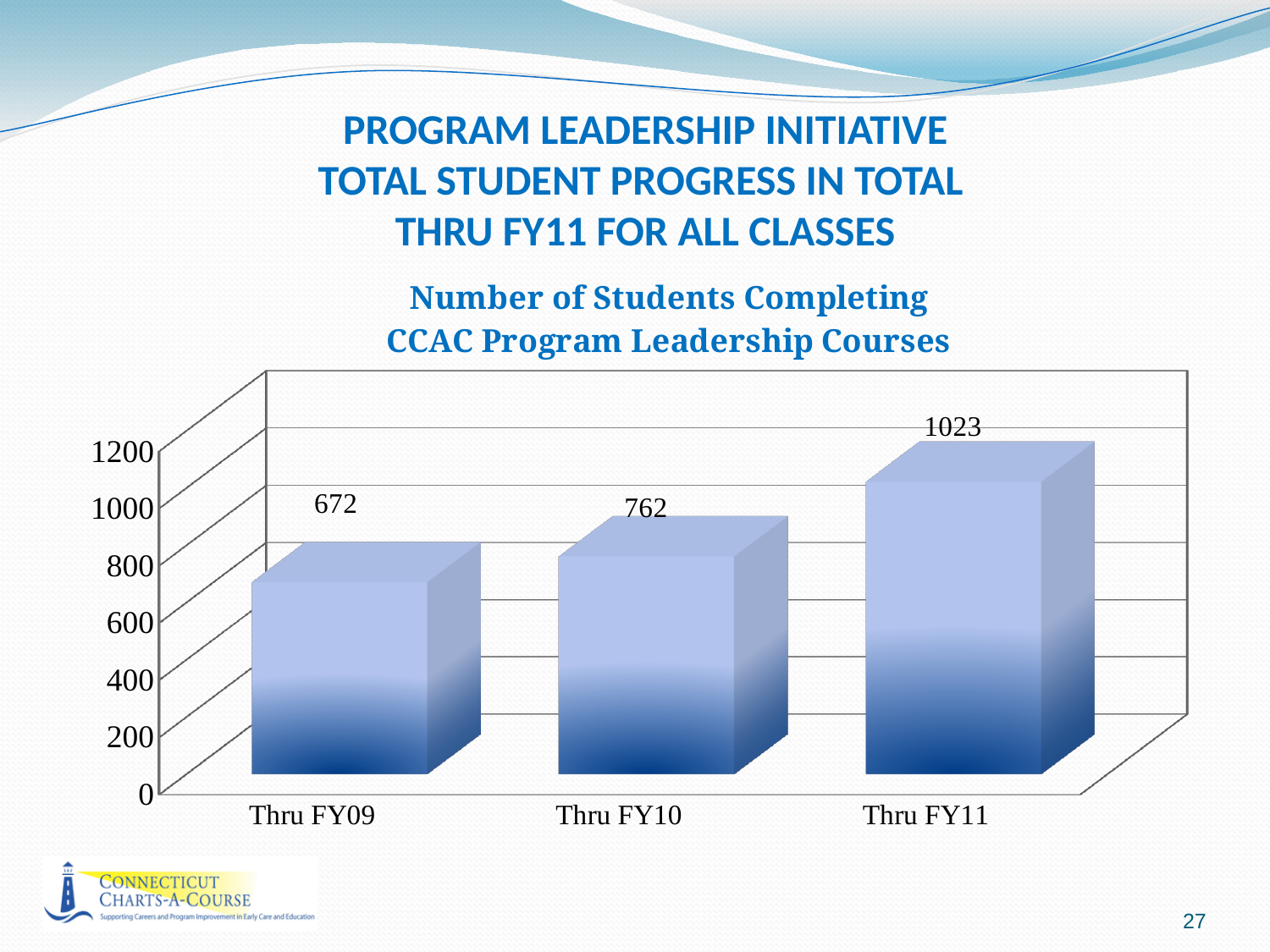
What is the number of students completing CCAC Program Leadership Courses thru FY10? 762 Do the values rise or fall from Thru FY09 to Thru FY11? rise What is the number of students completing CCAC Program Leadership Courses thru FY11? 1023 What is the difference between the values for Thru FY10 and Thru FY09? 90 What is the number of students completing CCAC Program Leadership Courses thru FY09? 672 How many categories are shown on the x axis? 3 Which category has the lowest value? Thru FY09 Which is larger, the value for Thru FY09 or the value for Thru FY10? Thru FY10 What kind of chart is shown on the slide? bar chart What is the difference between the values for Thru FY11 and Thru FY10? 261 Which category has the highest value? Thru FY11 Is the value for Thru FY11 greater or less than 1000? greater